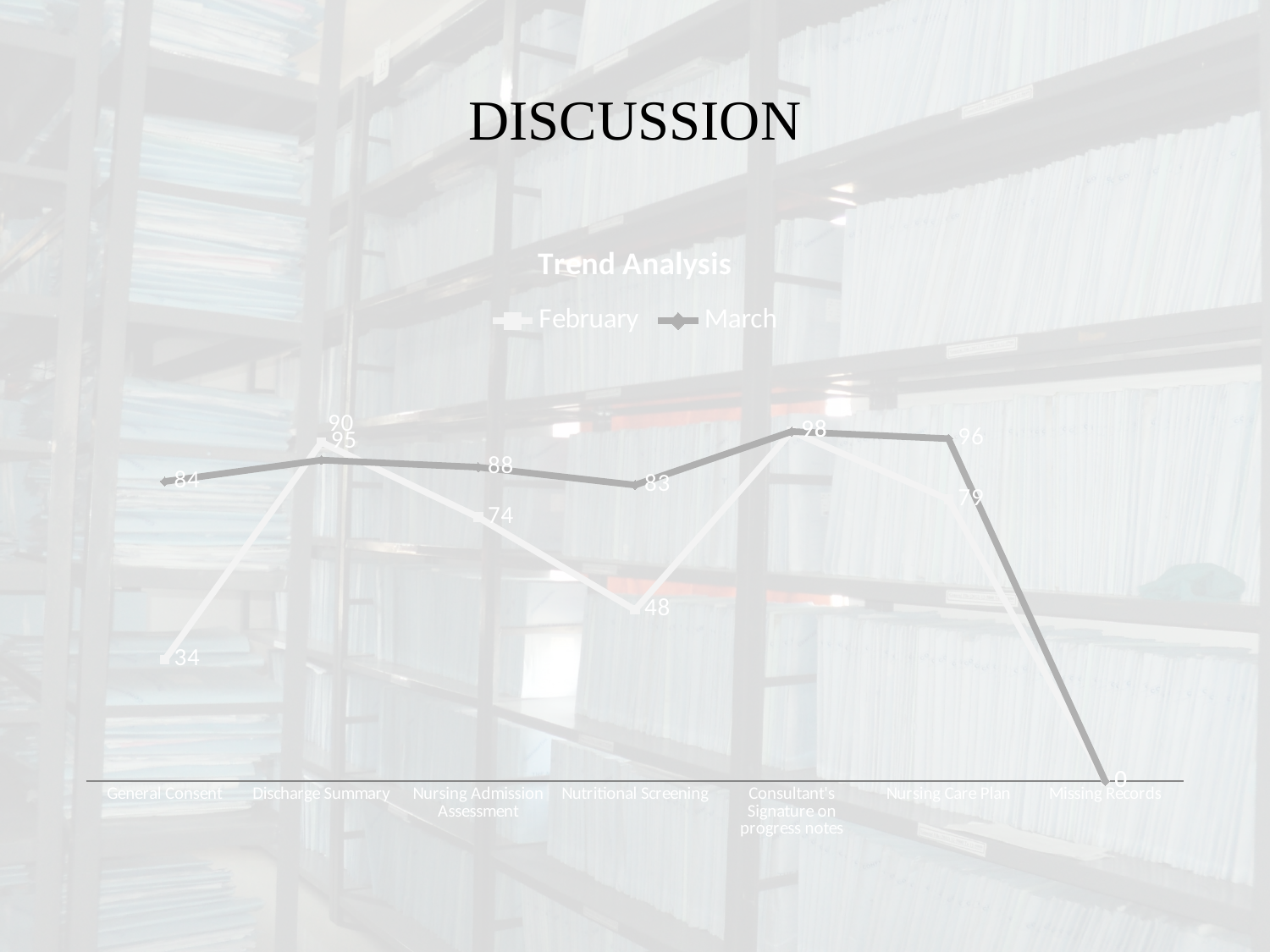
What is the difference between the March and February values for Discharge Summary? 5 How many categories are shown on the x axis of the chart? 7 What is the February value for Nutritional Screening? 48 For Nursing Admission Assessment, which series has the higher value, February or March? March What is the March value for Nutritional Screening? 83 What type of chart is shown on the slide? line chart How many series does the legend of the Trend Analysis chart list? 2 What is the February value for General Consent? 34 What is the March value for Nursing Care Plan? 96 What is the title of the chart? Trend Analysis What is the difference between the March and February values for General Consent? 50 What is the March value for General Consent? 84